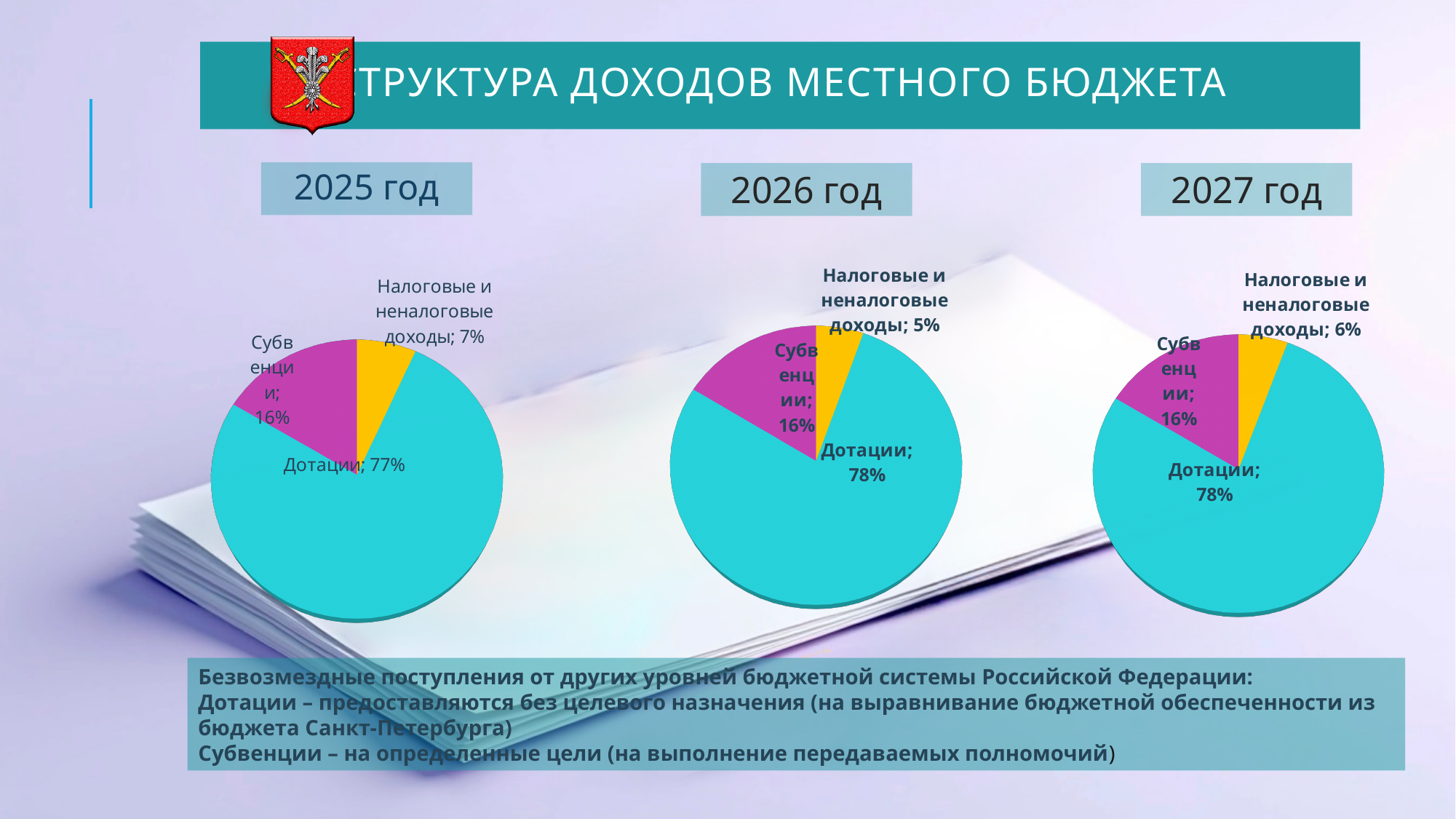
How many pie charts are shown on the slide? 3 In the 2027 год pie chart, what share is labelled for Субвенции? 16% In the 2026 год pie chart, what share is labelled for Налоговые и неналоговые доходы? 5% In the 2027 год pie chart, what is the difference in percentage points between Субвенции and Налоговые и неналоговые доходы? 10 In the 2025 год pie chart, what share is labelled for Дотации? 77% In the 2027 год pie chart, what share is labelled for Налоговые и неналоговые доходы? 6% In the 2026 год pie chart, which category has the smallest slice? Налоговые и неналоговые доходы What type of chart is used for 2026 год? Pie chart In the 2025 год pie chart, which category has the largest slice? Дотации In the 2025 год pie chart, what is the difference in percentage points between Дотации and Субвенции? 61 In the 2026 год pie chart, which is larger: Субвенции or Налоговые и неналоговые доходы? Субвенции How many slices does the 2025 год pie chart have? 3